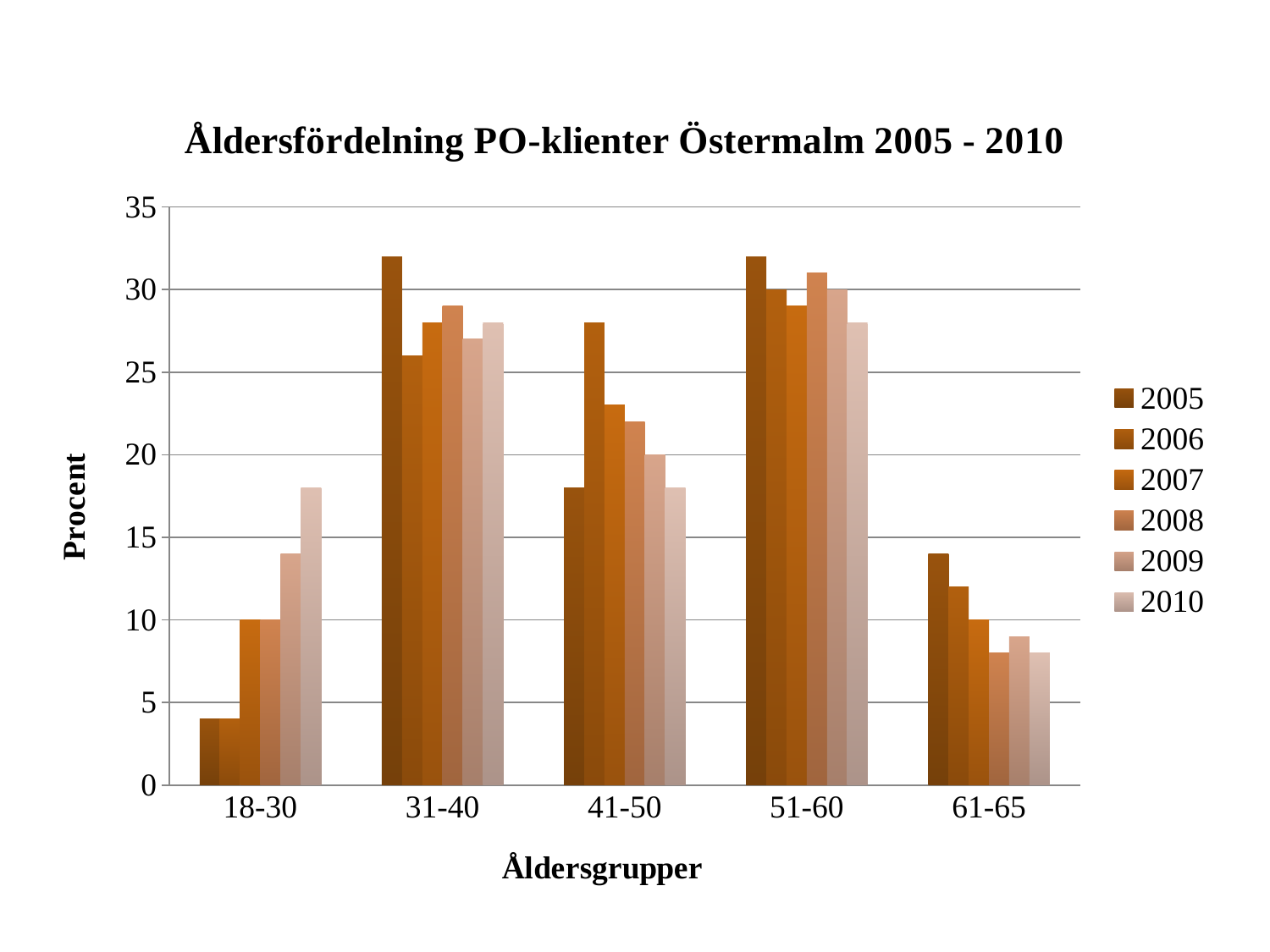
In the 41-50 age group, which is larger: the value for 2005 or the value for 2006? 2006 How many series does the legend list? 6 What is the label on the y axis? Procent What kind of chart is shown on the slide? bar chart What is the value for 2006 in the 51-60 age group? 30 Which year has the highest value in the 18-30 age group? 2010 Is the value for 2005 in the 41-50 age group greater or less than 20? less How many age groups are shown on the x axis? 5 What is the title of the chart? Åldersfördelning PO-klienter Östermalm 2005 - 2010 Is the value for 2005 in the 31-40 age group greater or less than 30? greater Is the value for 2010 in the 18-30 age group greater or less than 15? greater What is the value for 2009 in the 41-50 age group? 20